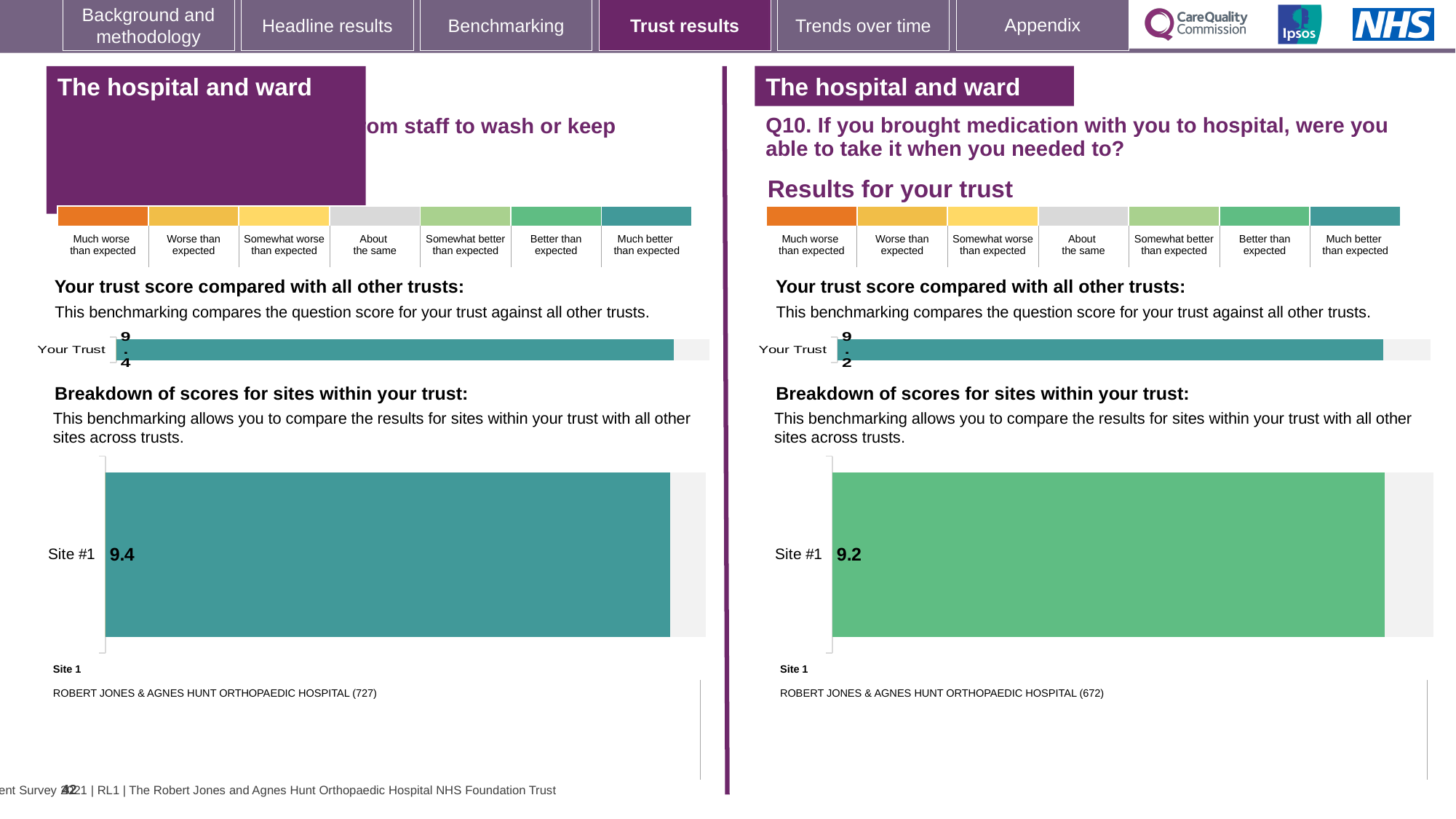
Is the Your Trust score on the right-hand panel (Q10) greater or less than 9.3? less Which is larger: the Site #1 score on the left-hand panel or the Site #1 score on the right-hand panel (Q10)? Left-hand panel (9.4) On the left-hand panel, what score is shown for Site #1 in the 'Breakdown of scores for sites within your trust' chart? 9.4 How many sites are shown in the 'Breakdown of scores for sites within your trust' chart on the right-hand panel (Q10)? 1 On the right-hand panel (Q10, medication), what score is shown for Site #1 in the 'Breakdown of scores for sites within your trust' chart? 9.2 How many sites are shown in the 'Breakdown of scores for sites within your trust' chart on the left-hand panel? 1 What is the difference between the Site #1 score on the left-hand panel (9.4) and the Site #1 score on the right-hand panel (9.2)? 0.2 On the right-hand panel (Q10), which benchmarking category does the colour of the Site #1 bar correspond to in the legend? Better than expected On the right-hand panel (Q10, medication), what is the score shown for Your Trust in the 'Your trust score compared with all other trusts' chart? 9.2 On the left-hand panel, which benchmarking category does the colour of the Site #1 bar correspond to in the legend? Much better than expected What kind of chart is used to show the Site #1 score on the right-hand panel (Q10)? Bar chart On the left-hand panel, what is the score shown for Your Trust in the 'Your trust score compared with all other trusts' chart? 9.4